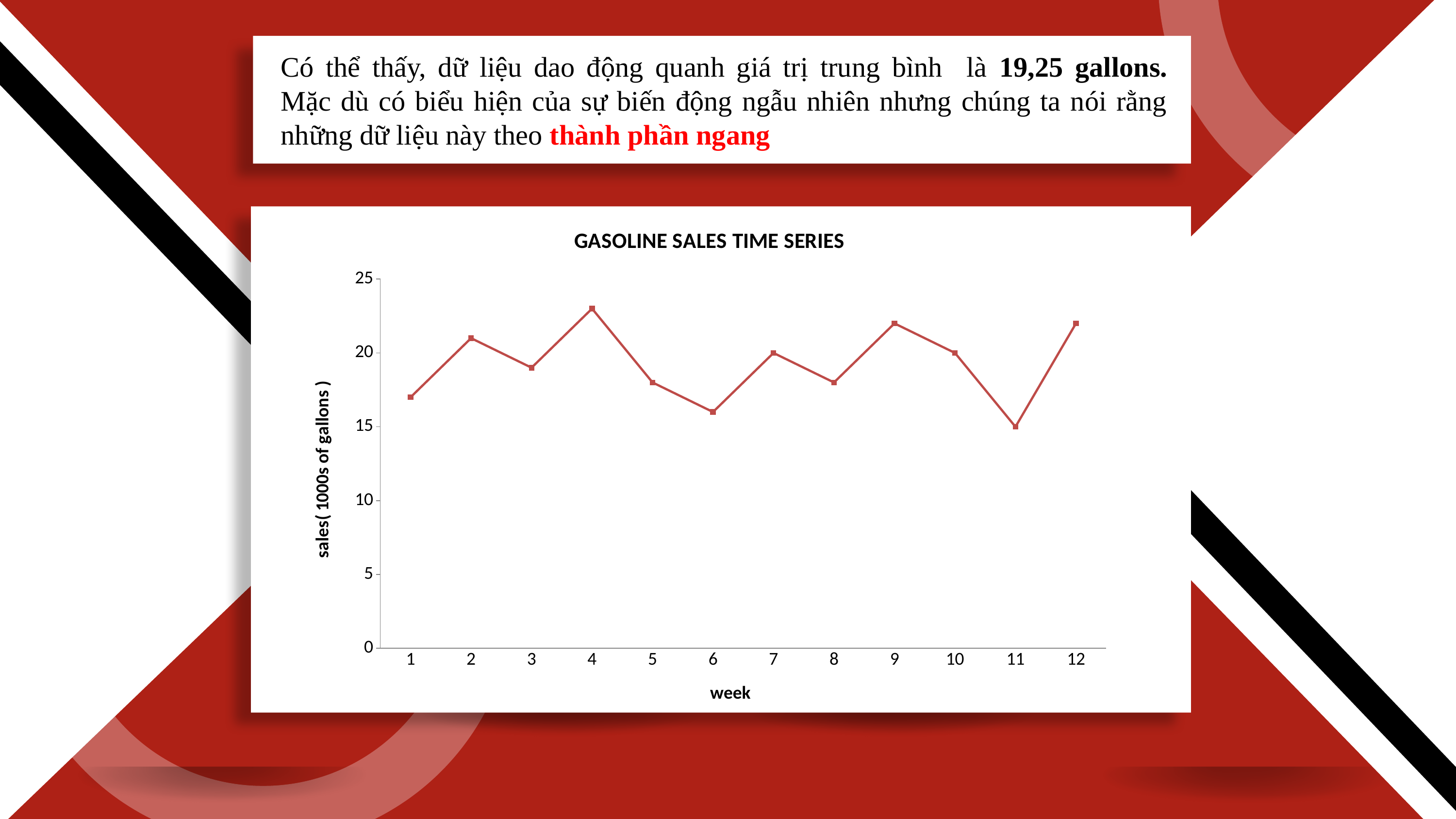
How many weeks are plotted on the chart? 12 Is the sales value for week 4 greater or less than 20? greater What is the label of the vertical axis of the chart? sales( 1000s of gallons ) Is the sales value for week 1 greater or less than 20? less What is the sales value for week 7? 20 Which week has the lowest sales value? 11 Which week has the larger sales value, week 4 or week 6? 4 What is the title of the chart? GASOLINE SALES TIME SERIES Which week has the highest sales value? 4 What kind of chart is shown on the slide? line chart Is the sales value for week 6 greater or less than 20? less What is the sales value for week 11? 15